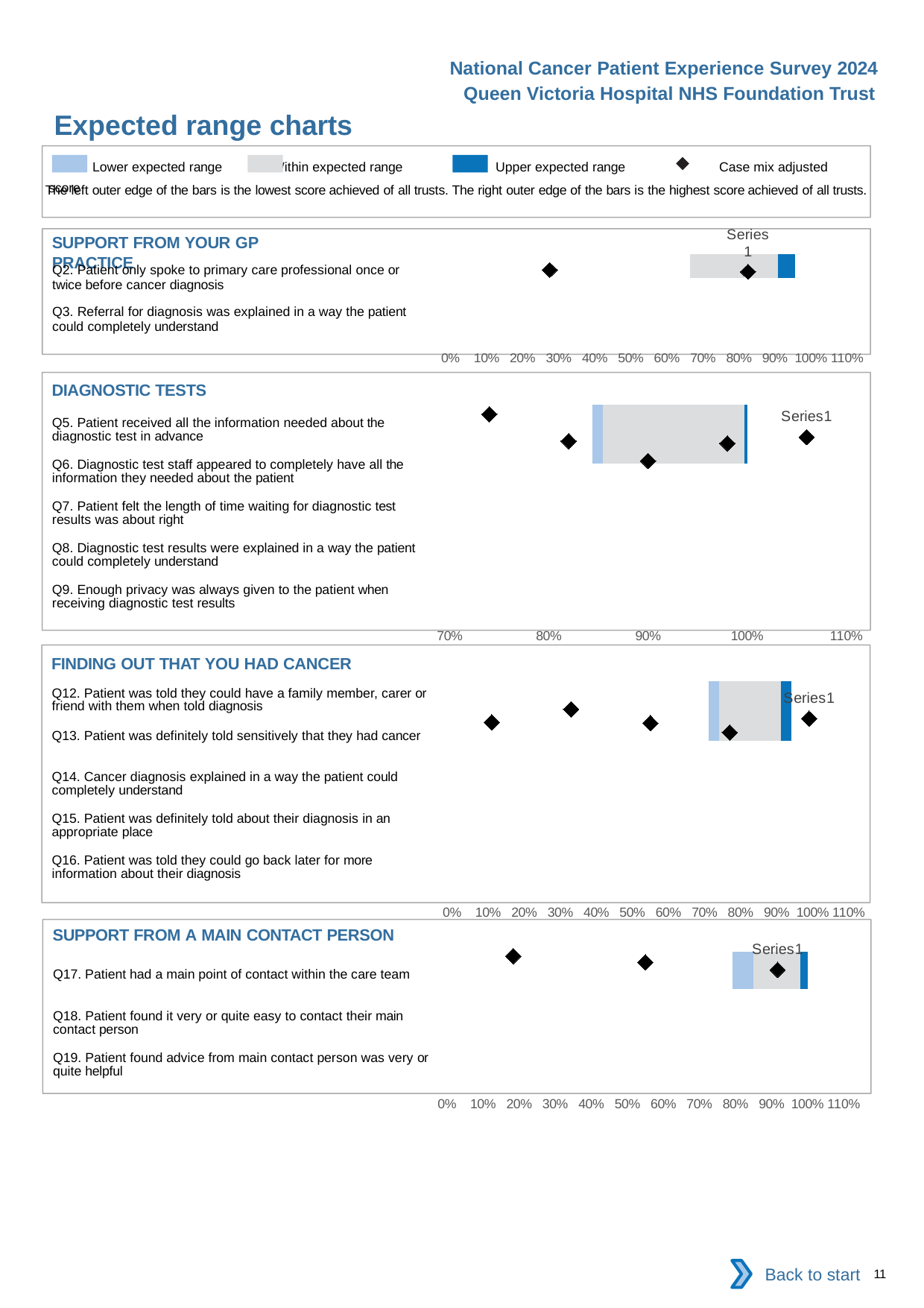
In the SUPPORT FROM A MAIN CONTACT PERSON chart, is the leftmost diamond marker greater or less than 30%? less How many entries does the legend at the top of the slide list? 4 How many questions are listed in the DIAGNOSTIC TESTS section? 5 In the SUPPORT FROM YOUR GP PRACTICE chart, how many diamond markers are plotted? 2 What is the lowest tick label on the x axis of the DIAGNOSTIC TESTS chart? 70% What kind of chart is used in the DIAGNOSTIC TESTS section? bar chart In the DIAGNOSTIC TESTS chart, how many diamond markers are plotted? 5 In the DIAGNOSTIC TESTS chart, is the leftmost diamond marker greater or less than 80%? less In the FINDING OUT THAT YOU HAD CANCER chart, is the leftmost diamond marker greater or less than 20%? less